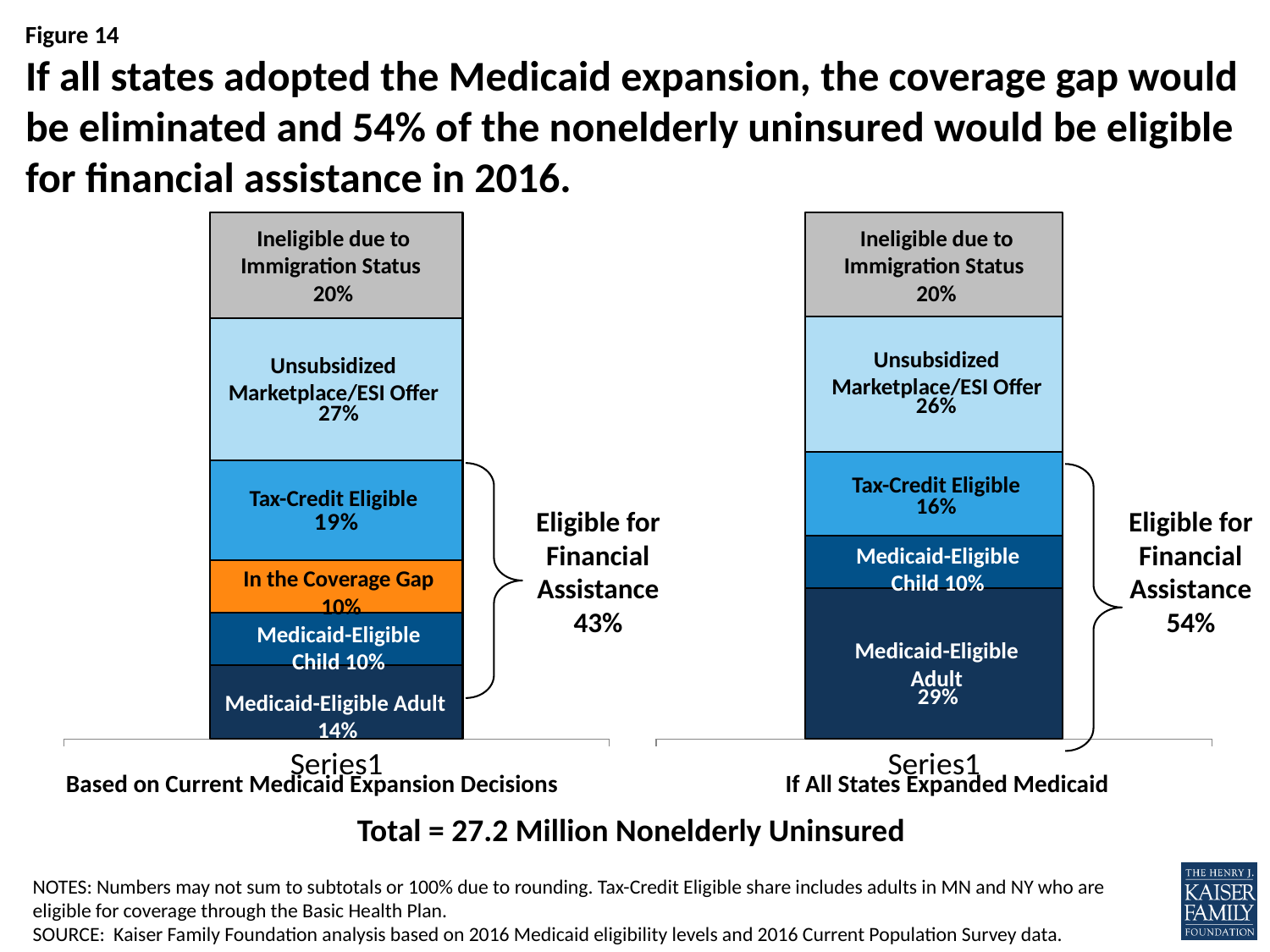
How many segments does the bar in the chart labeled 'Based on Current Medicaid Expansion Decisions' have? 6 Is the Tax-Credit Eligible share larger in the 'Based on Current Medicaid Expansion Decisions' chart or the 'If All States Expanded Medicaid' chart? Based on Current Medicaid Expansion Decisions How many segments does the bar in the chart labeled 'If All States Expanded Medicaid' have? 5 In the chart labeled 'If All States Expanded Medicaid', what percentage is Medicaid-Eligible Adult? 29% In the chart labeled 'Based on Current Medicaid Expansion Decisions', which segment is the largest? Unsubsidized Marketplace/ESI Offer In the chart labeled 'If All States Expanded Medicaid', what percentage is Unsubsidized Marketplace/ESI Offer? 26% In the chart labeled 'If All States Expanded Medicaid', which segment is the smallest? Medicaid-Eligible Child In the chart labeled 'Based on Current Medicaid Expansion Decisions', what percentage is In the Coverage Gap? 10% According to the bracket label, what share is Eligible for Financial Assistance in the chart labeled 'If All States Expanded Medicaid'? 54% In the chart labeled 'Based on Current Medicaid Expansion Decisions', what percentage is Tax-Credit Eligible? 19% What type of chart is used on this slide? Stacked bar chart What is the difference in the Medicaid-Eligible Adult percentage between the 'If All States Expanded Medicaid' chart and the 'Based on Current Medicaid Expansion Decisions' chart? 15 percentage points